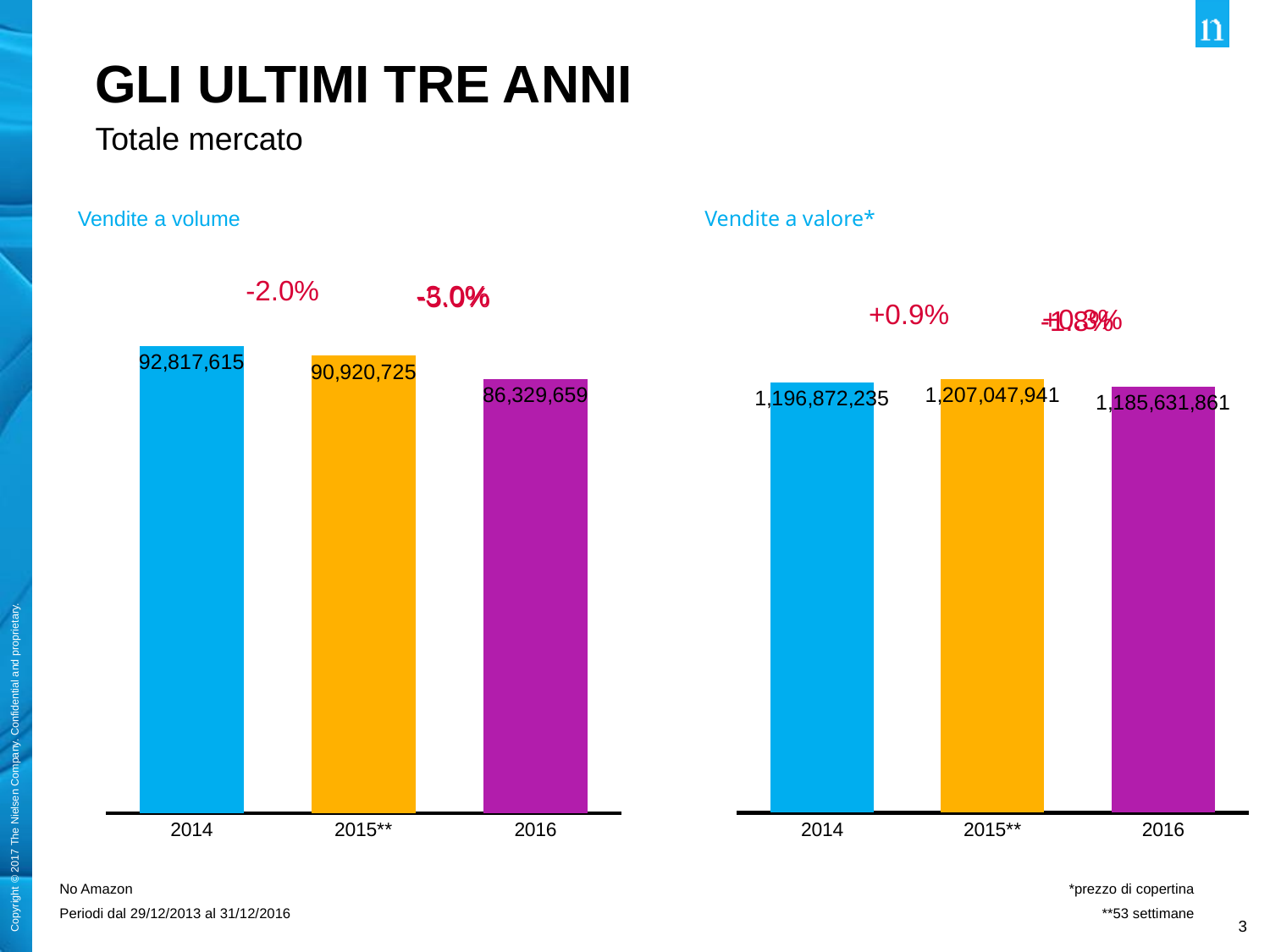
On the 'Vendite a volume' chart, do the values rise or fall from 2014 to 2016? Fall On the 'Vendite a valore*' chart, which is larger, the value for 2014 or the value for 2016? 2014 On the 'Vendite a volume' chart, what is the value for 2016? 86,329,659 On the 'Vendite a valore*' chart, what is the value for 2016? 1,185,631,861 On the 'Vendite a valore*' chart, which year has the lowest value? 2016 On the 'Vendite a valore*' chart, what is the difference between the 2015** and 2014 values? 10,175,706 What kind of chart is the 'Vendite a valore*' chart? Bar chart On the 'Vendite a volume' chart, which year has the highest value? 2014 On the 'Vendite a volume' chart, what is the difference between the 2015** and 2016 values? 4,591,066 On the 'Vendite a valore*' chart, what is the value for 2015**? 1,207,047,941 On the 'Vendite a volume' chart, what is the value for 2014? 92,817,615 How many bars are shown on the 'Vendite a volume' chart? 3